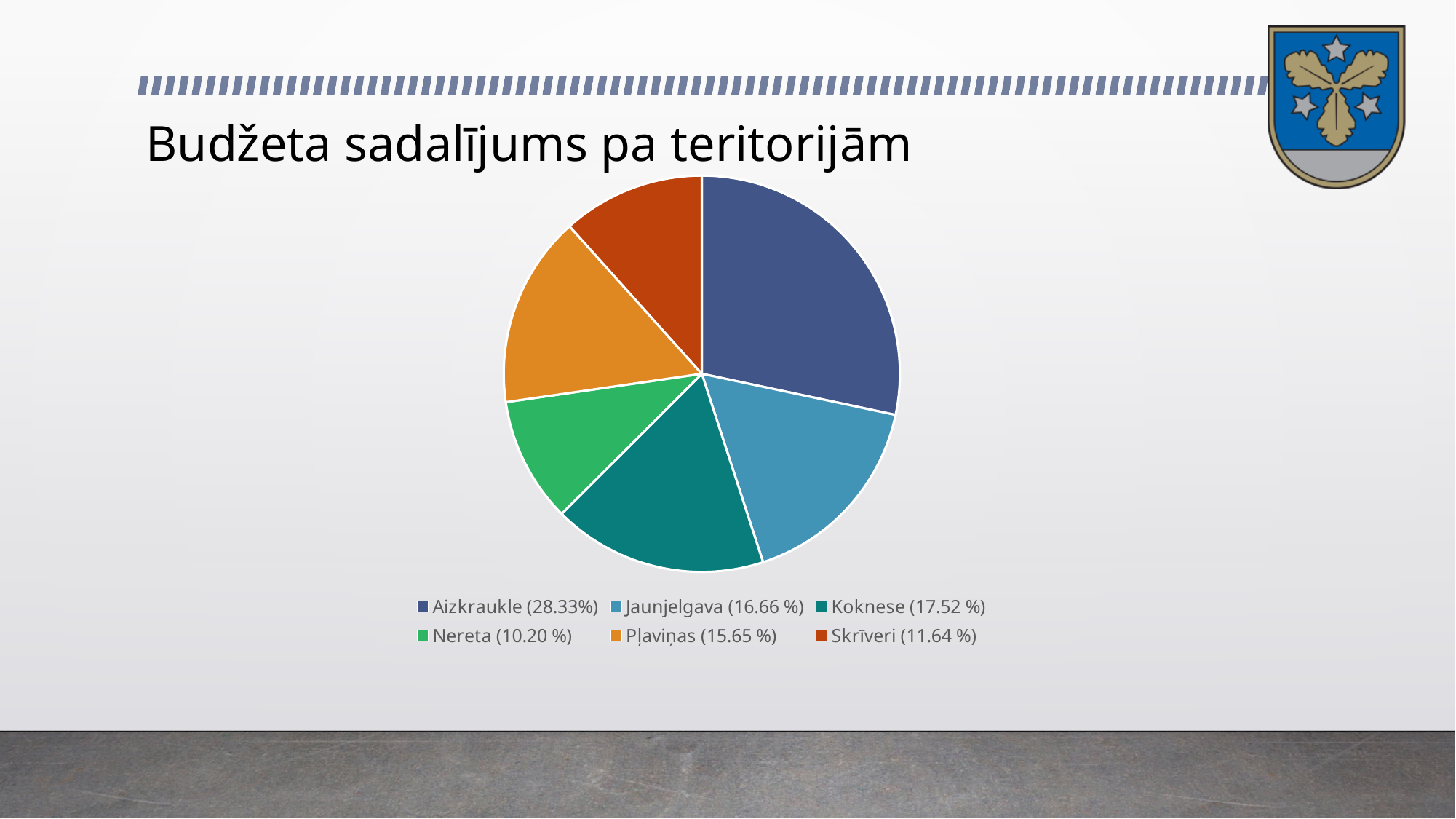
What percentage is shown for Pļaviņas in the legend? 15.65 % Which has a larger share, Koknese or Skrīveri? Koknese What is the title of the chart? Budžeta sadalījums pa teritorijām What share of the budget does Aizkraukle have according to the legend? 28.33% Which territory has the largest share of the budget? Aizkraukle What type of chart is shown on the slide? pie chart How many slices does the pie chart have? 6 Which territory has the smallest share of the budget? Nereta What percentage is shown for Skrīveri in the legend? 11.64 % What is the difference in percentage points between Aizkraukle and Jaunjelgava? 11.67 Which colour represents Pļaviņas in the pie chart? orange What percentage is shown for Nereta in the legend? 10.20 %